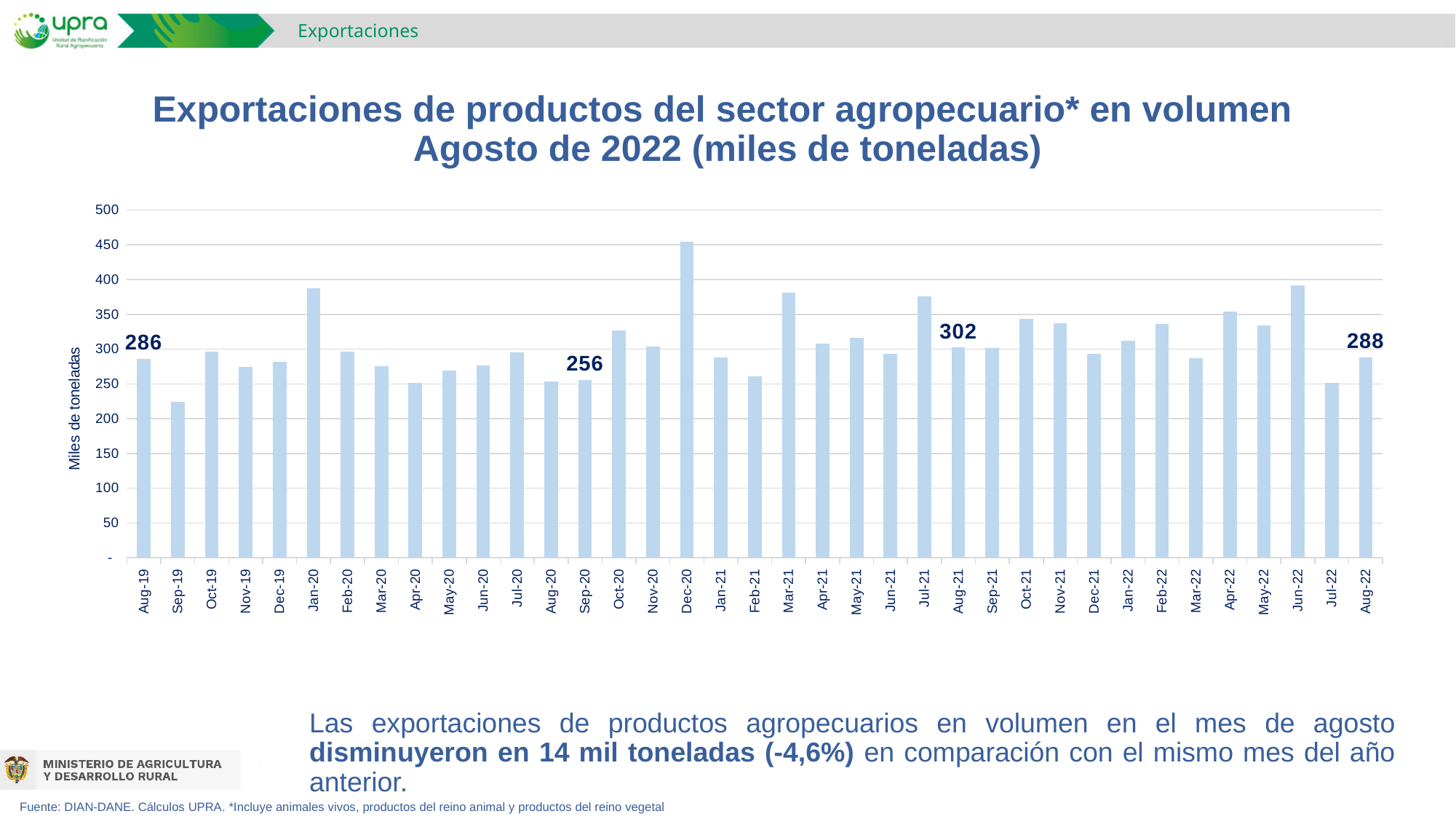
Which month has the lowest value? Sep-19 What is the value for Sep-20? 256 Which month has the highest value? Dec-20 What is the value for Aug-19? 286 How many months are plotted on the chart? 37 Which is larger, the value for Aug-21 or the value for Aug-22? Aug-21 What is the value for Aug-21? 302 What is the difference between the values for Aug-21 and Aug-22? 14 What kind of chart is shown? bar chart What is the value for Aug-22? 288 Is the value for Sep-19 greater or less than 250? less Is the value for Dec-20 greater or less than 400? greater